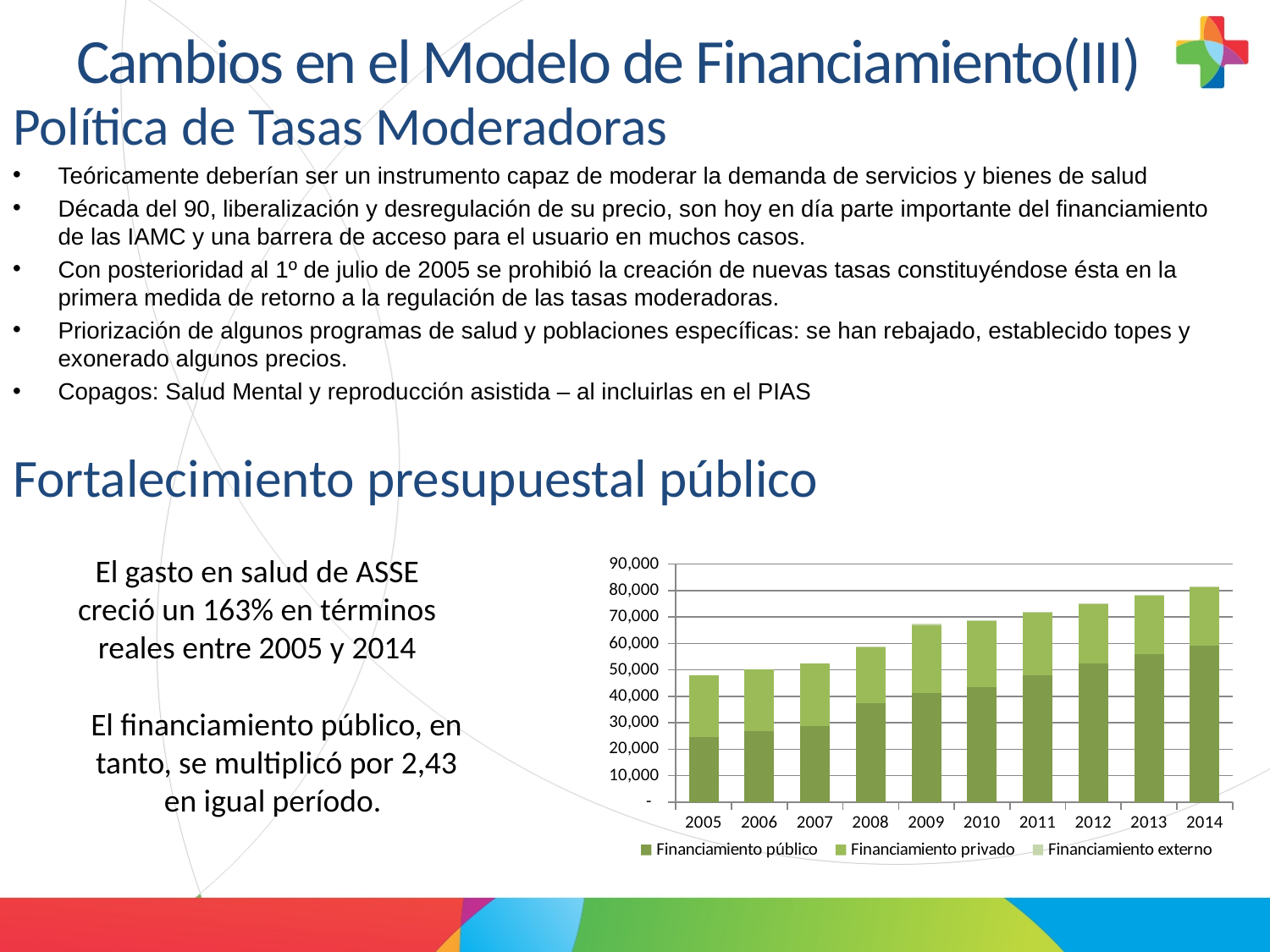
Is the Financiamiento público value for 2005 greater or less than 30,000? less What kind of chart is shown on the slide? Stacked bar chart Is the total bar for 2014 greater or less than 70,000? greater Which year has the tallest total bar in the chart? 2014 Is the total bar for 2005 greater or less than 40,000? greater How many series does the chart's legend list? 3 How many years are shown on the x axis of the chart? 10 Which year has the larger total bar, 2007 or 2010? 2010 Which year has the shortest total bar in the chart? 2005 Which series are listed in the chart's legend? Financiamiento público, Financiamiento privado, Financiamiento externo Do the total bar heights rise or fall from 2005 to 2014? Rise